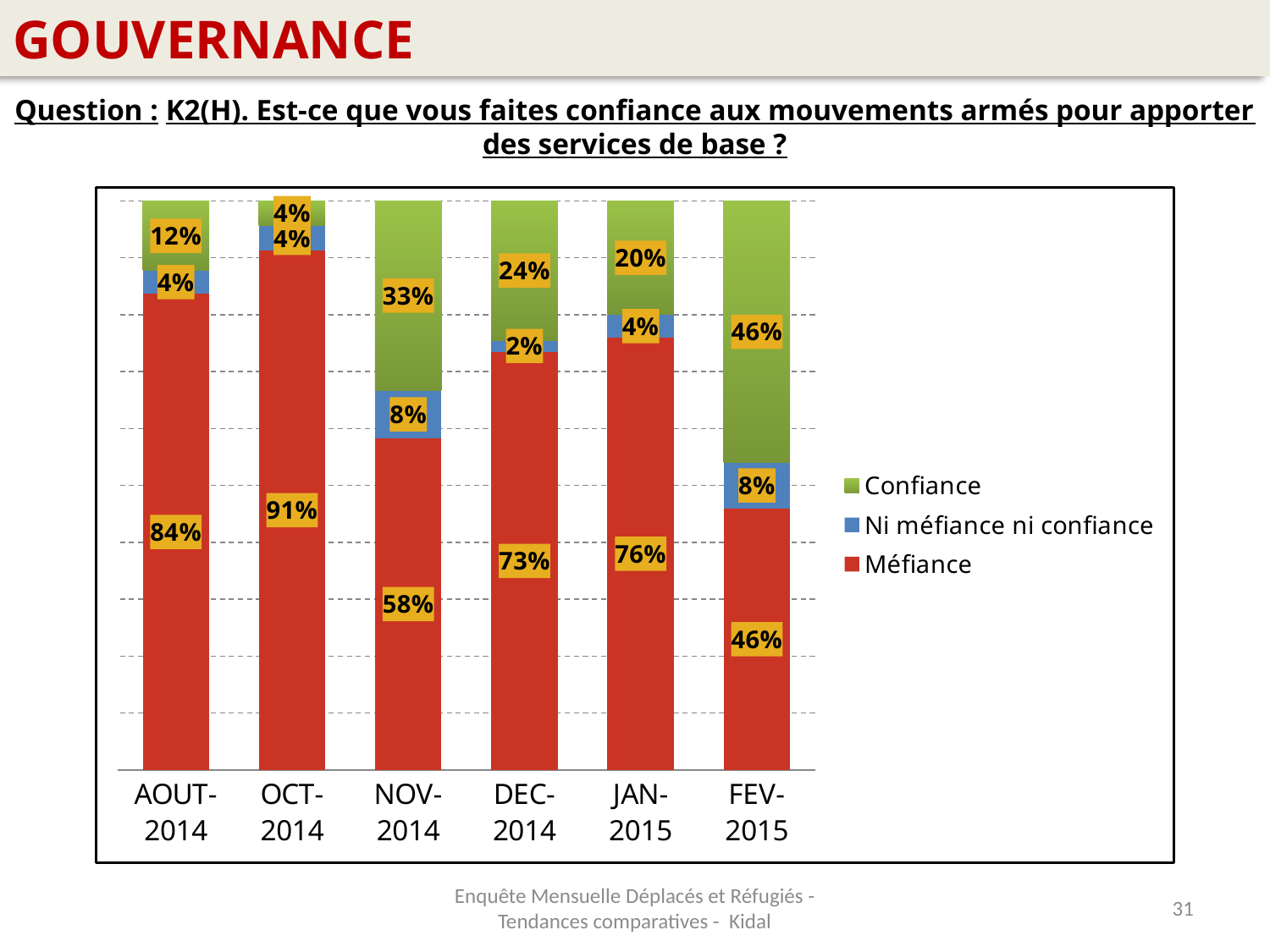
Which month has the highest Méfiance value? OCT-2014 What is the Confiance value for NOV-2014? 33% Which is larger, the Confiance value for DEC-2014 or for JAN-2015? DEC-2014 How many series does the legend list? 3 What is the Méfiance value for OCT-2014? 91% What is the Ni méfiance ni confiance value for DEC-2014? 2% What is the Confiance value for FEV-2015? 46% How many months are shown on the x axis? 6 What is the difference between the Méfiance values for AOUT-2014 and FEV-2015? 38% Which colour represents Méfiance in the chart? Red What kind of chart is shown on the slide? Stacked bar chart Which month has the lowest Méfiance value? FEV-2015